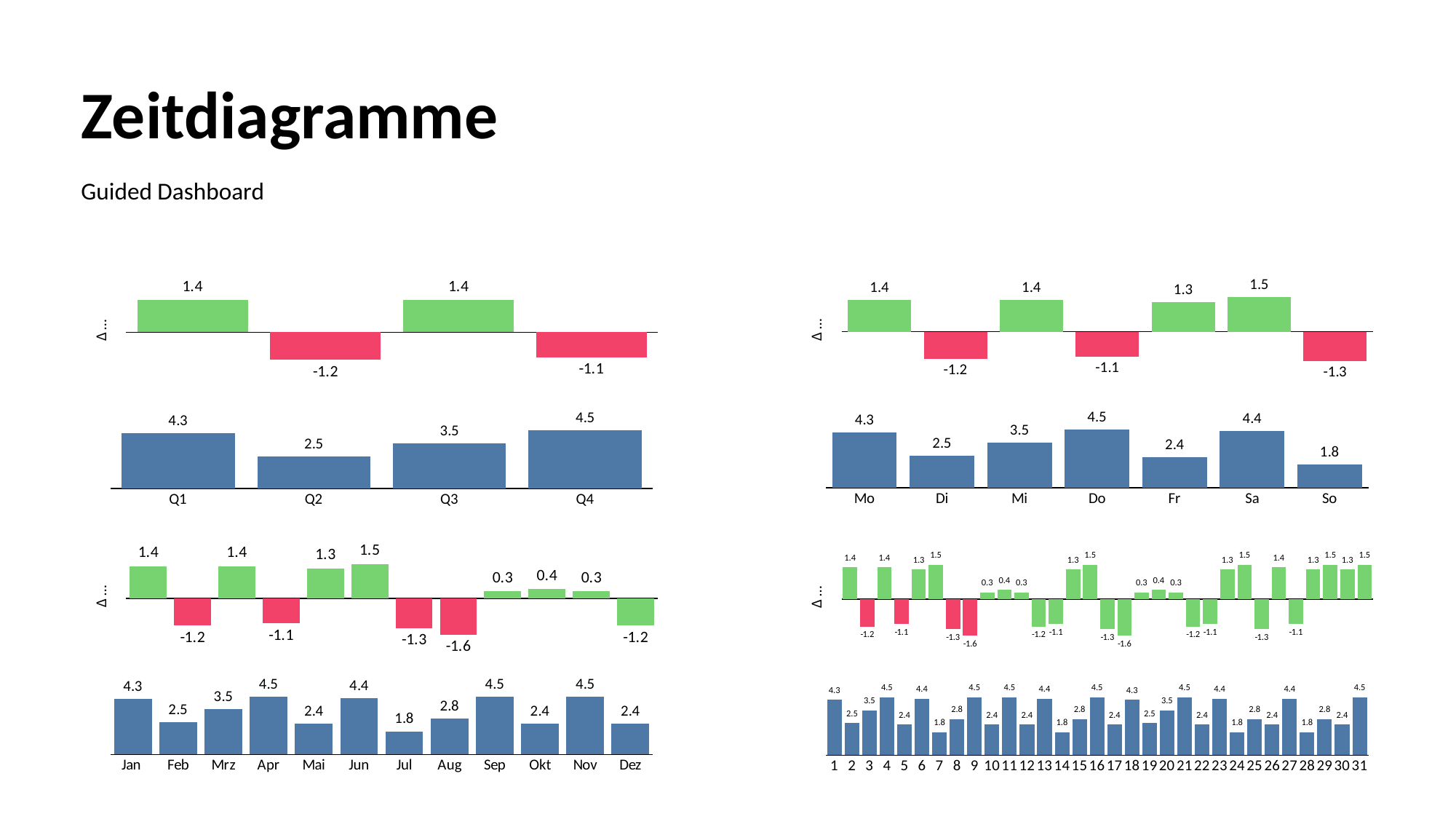
In the weekday delta chart (green/red bars above Mo–So), what is the value for So? -1.3 In the monthly bar chart (Jan–Dez, blue bars), is the value for Jun larger than the value for Aug? Yes In the weekday bar chart (Mo–So, blue bars), which day has the lowest value? So In the quarterly delta chart (green/red bars above Q1–Q4), what is the value for Q2? -1.2 In the quarterly bar chart (Q1–Q4, blue bars), which quarter has the highest value? Q4 In the weekday delta chart (green/red bars above Mo–So), how many days have a negative (red) value? 3 In the weekday bar chart (Mo–So, blue bars), what is the value for Sa? 4.4 In the quarterly bar chart (Q1–Q4, blue bars), what is the difference between Q4 and Q2? 2.0 In the daily bar chart (1–31, blue bars), how many categories are shown on the x axis? 31 In the monthly delta chart (green/red bars above Jan–Dez), what is the value for Aug? -1.6 In the quarterly bar chart (Q1–Q4, blue bars), what is the value for Q3? 3.5 In the monthly bar chart (Jan–Dez, blue bars), which month has the lowest value? Jul